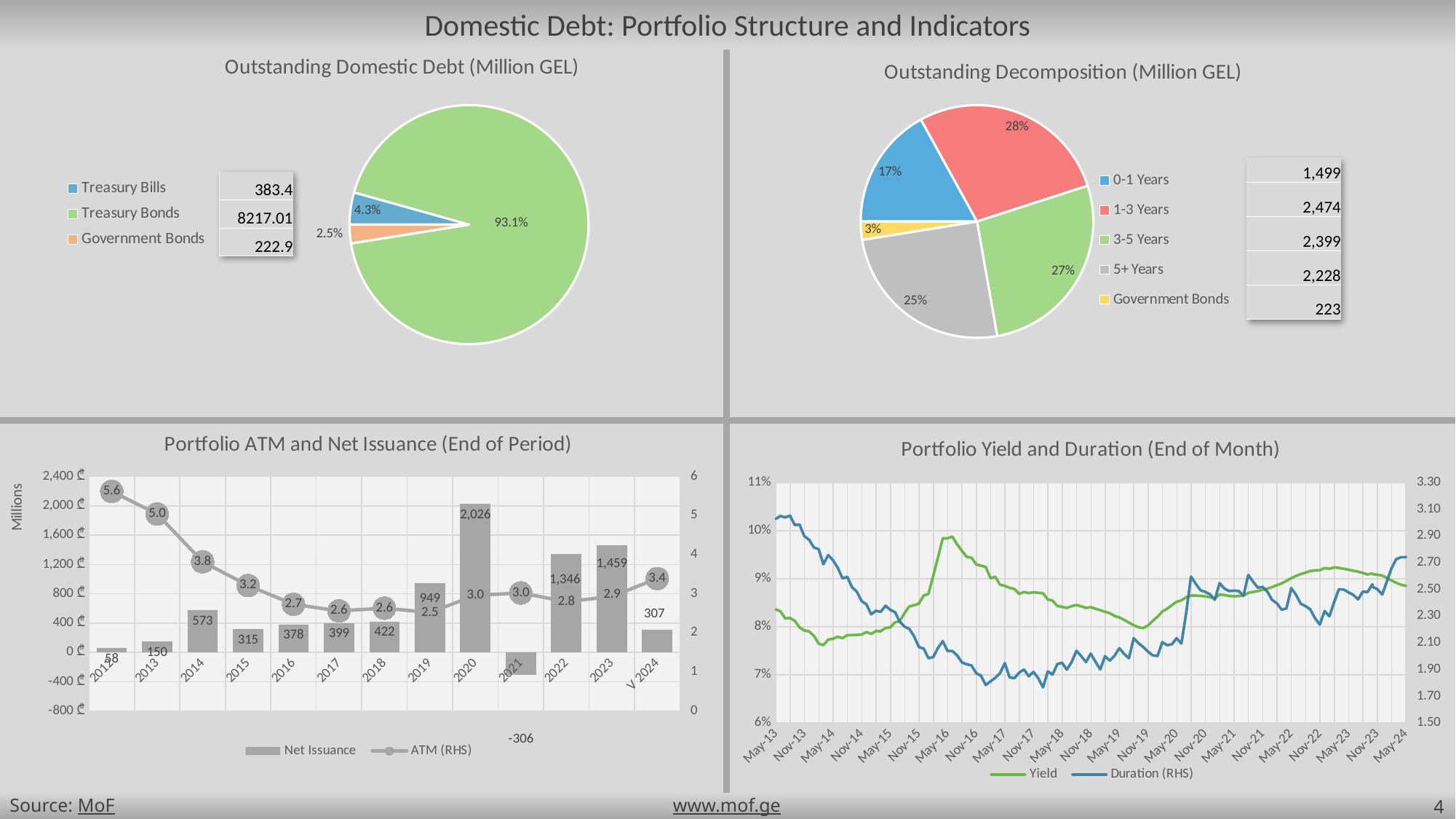
In the Outstanding Decomposition (Million GEL) chart, what is the value for 1-3 Years? 2,474 In the Portfolio ATM and Net Issuance (End of Period) chart, what is the Net Issuance for 2020? 2,026 In the Outstanding Domestic Debt (Million GEL) chart, what is the value for Treasury Bonds? 8217.01 In the Outstanding Domestic Debt (Million GEL) chart, what share of the pie is Treasury Bills? 4.3% In the Portfolio ATM and Net Issuance (End of Period) chart, which year has the lowest Net Issuance? 2021 In the Portfolio ATM and Net Issuance (End of Period) chart, does the ATM (RHS) line rise or fall from 2012 to 2019? fall In the Portfolio ATM and Net Issuance (End of Period) chart, what is the ATM (RHS) value for 2012? 5.6 In the Outstanding Decomposition (Million GEL) chart, how many categories does the legend list? 5 In the Outstanding Decomposition (Million GEL) chart, which category has the smallest slice? Government Bonds In the Portfolio Yield and Duration (End of Month) chart, how many series does the legend list? 2 In the Portfolio ATM and Net Issuance (End of Period) chart, what is the difference between Net Issuance in 2023 and 2022? 113 In the Outstanding Decomposition (Million GEL) chart, which category has the largest slice? 1-3 Years